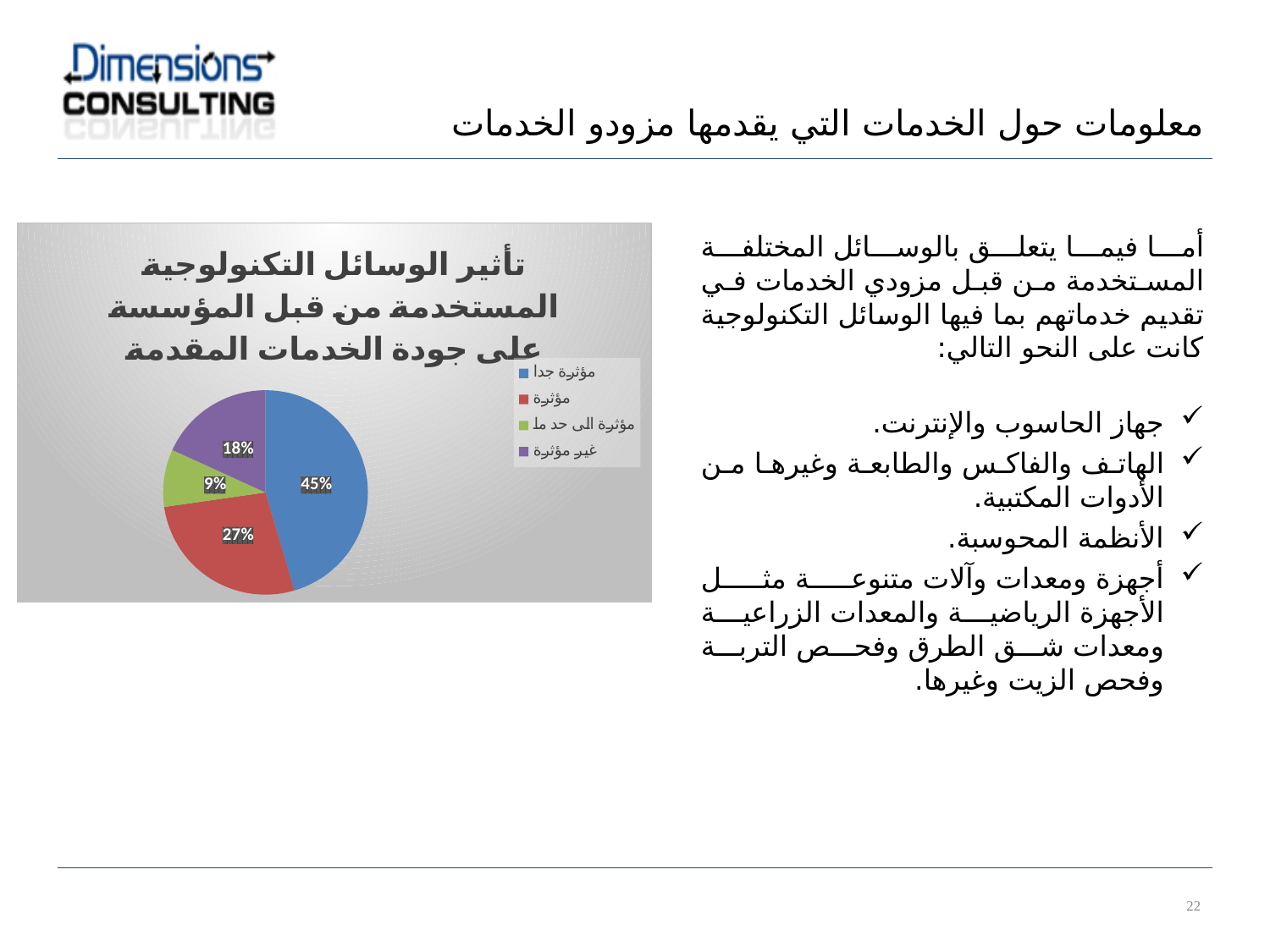
Which is larger, the slice for غير مؤثرة or the slice for مؤثرة الى حد ما? غير مؤثرة What percentage of the pie is labelled مؤثرة? 27% Which category has the largest slice of the pie? مؤثرة جدا What percentage of the pie is labelled مؤثرة جدا? 45% How many entries does the legend list? 4 What colour is the slice for مؤثرة جدا? blue Which category has the smallest slice of the pie? مؤثرة الى حد ما What percentage of the pie is labelled غير مؤثرة? 18% How many slices does the pie chart have? 4 What is the difference in percentage points between مؤثرة جدا and مؤثرة? 18% What type of chart is shown on the slide? pie chart What percentage of the pie is labelled مؤثرة الى حد ما? 9%